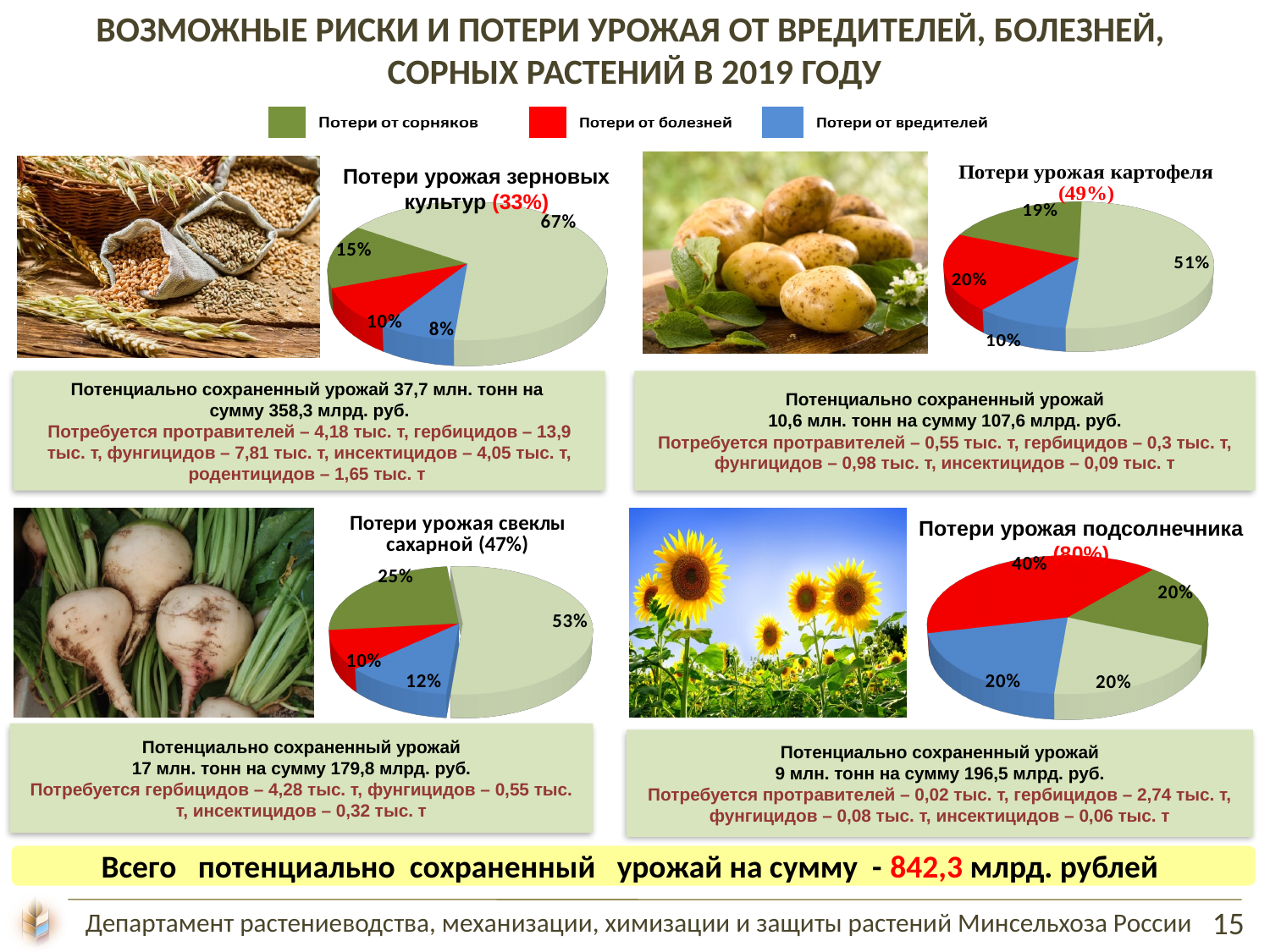
In the chart 'Потери урожая свеклы сахарной', which is larger: the blue slice (Потери от вредителей) or the red slice (Потери от болезней)? Потери от вредителей How many entries does the legend at the top of the slide list? 3 In the chart 'Потери урожая подсолнечника', what is the value of the red slice (Потери от болезней)? 40% In the chart 'Потери урожая зерновых культур', what is the value of the blue slice (Потери от вредителей)? 8% In the chart 'Потери урожая картофеля', what share is shown for the red slice (Потери от болезней)? 20% In the chart 'Потери урожая подсолнечника', which loss category has the largest slice? Потери от болезней What type of chart is used for 'Потери урожая картофеля'? Pie chart How many pie charts are shown on the slide? 4 In the chart 'Потери урожая свеклы сахарной', what is the value of the green slice (Потери от сорняков)? 25% In the chart 'Потери урожая картофеля', what is the difference between the red slice (20%) and the blue slice (10%)? 10% In the chart 'Потери урожая зерновых культур', which loss category has the smallest slice? Потери от вредителей In the chart 'Потери урожая зерновых культур', what share is labelled for the green slice (Потери от сорняков)? 15%